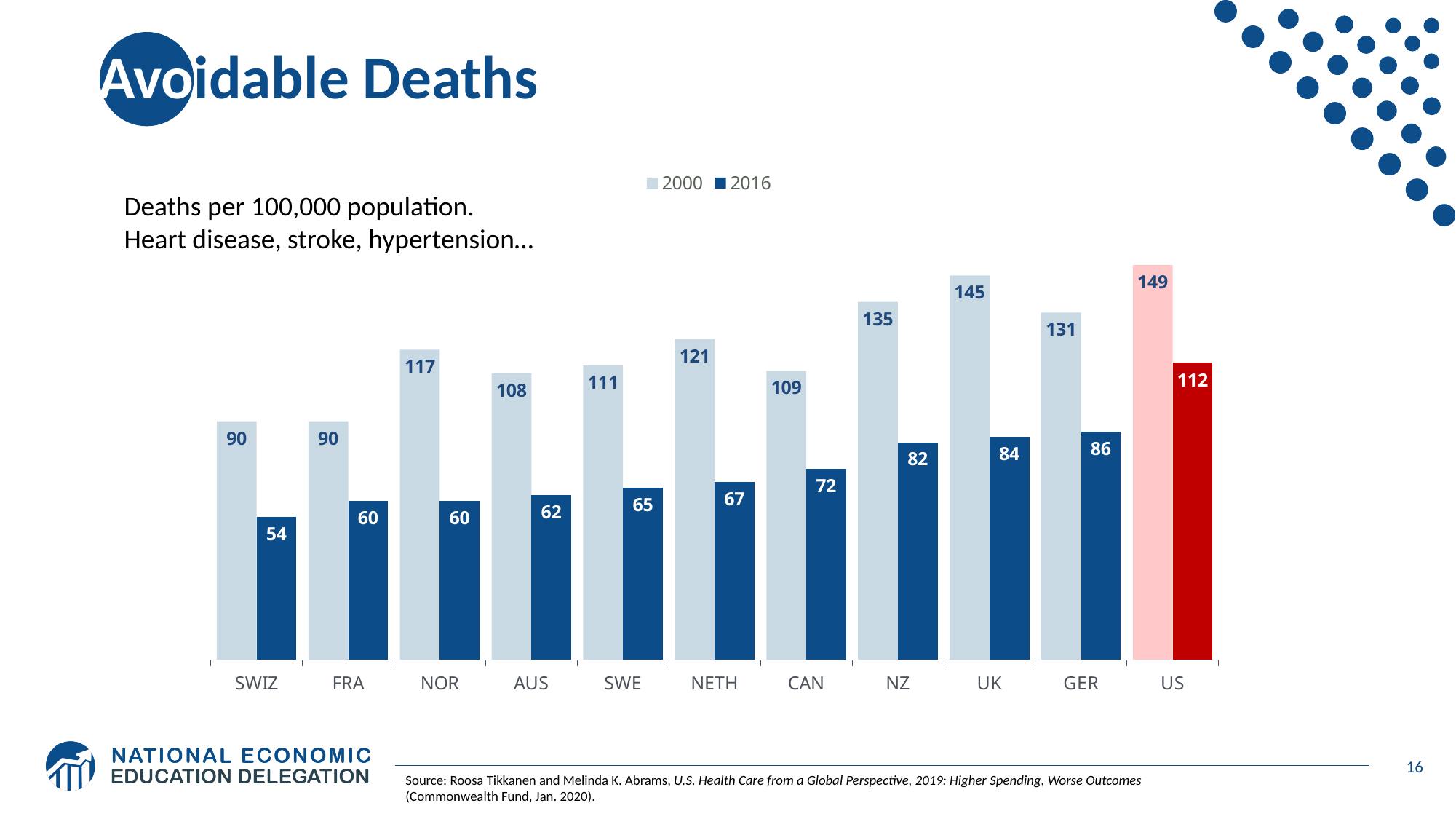
Which country has the highest 2000 value? US How many countries are shown on the x axis? 11 Which country's bars are coloured red instead of blue? US What is the 2016 value for the US? 112 Which is larger, the 2016 value for GER or the 2016 value for CAN? GER How many series does the legend list? 2 What is the 2000 value for NOR? 117 What is the difference between the 2000 and 2016 values for the UK? 61 What kind of chart is shown on the slide? Bar chart What is the 2016 value for SWIZ? 54 What are the two series listed in the legend? 2000 and 2016 Which country has the lowest 2016 value? SWIZ